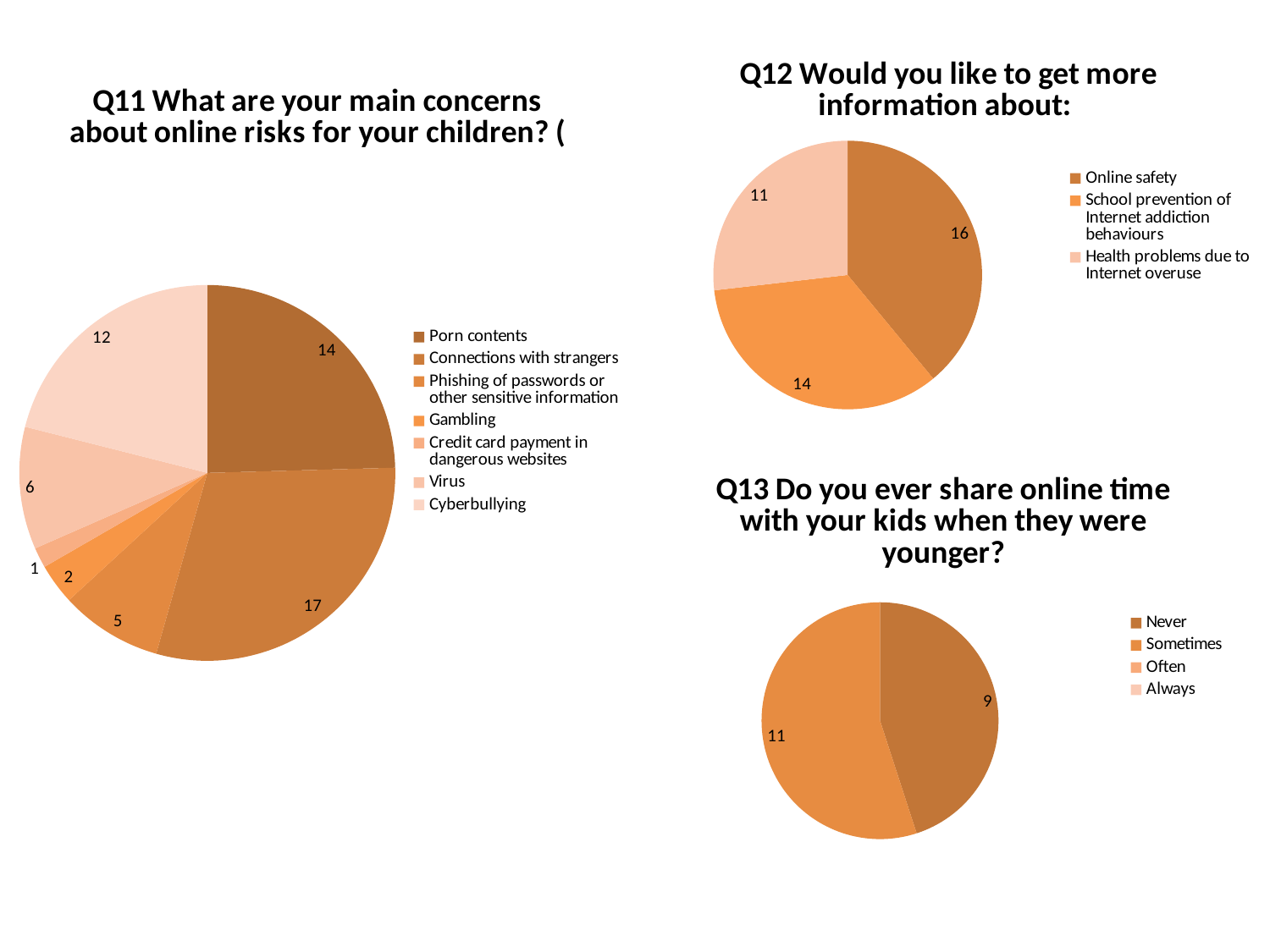
In the Q12 chart, what is the total of all slices? 41 In the Q12 chart, what is the value for Health problems due to Internet overuse? 11 In the Q11 chart, what is the value for Connections with strangers? 17 In the Q12 chart, which is larger: Online safety or School prevention of Internet addiction behaviours? Online safety In the Q11 chart, what is the difference between the values for Cyberbullying and Virus? 6 In the Q13 chart, what share of the total does Never represent? 45% How many entries does the legend of the Q13 chart list? 4 In the Q11 chart, which category has the largest value? Connections with strangers What type of chart is used for Q13? Pie chart How many categories does the legend of the Q11 chart list? 7 In the Q11 chart, which category has the smallest value? Credit card payment in dangerous websites In the Q13 chart, what is the value for Sometimes? 11